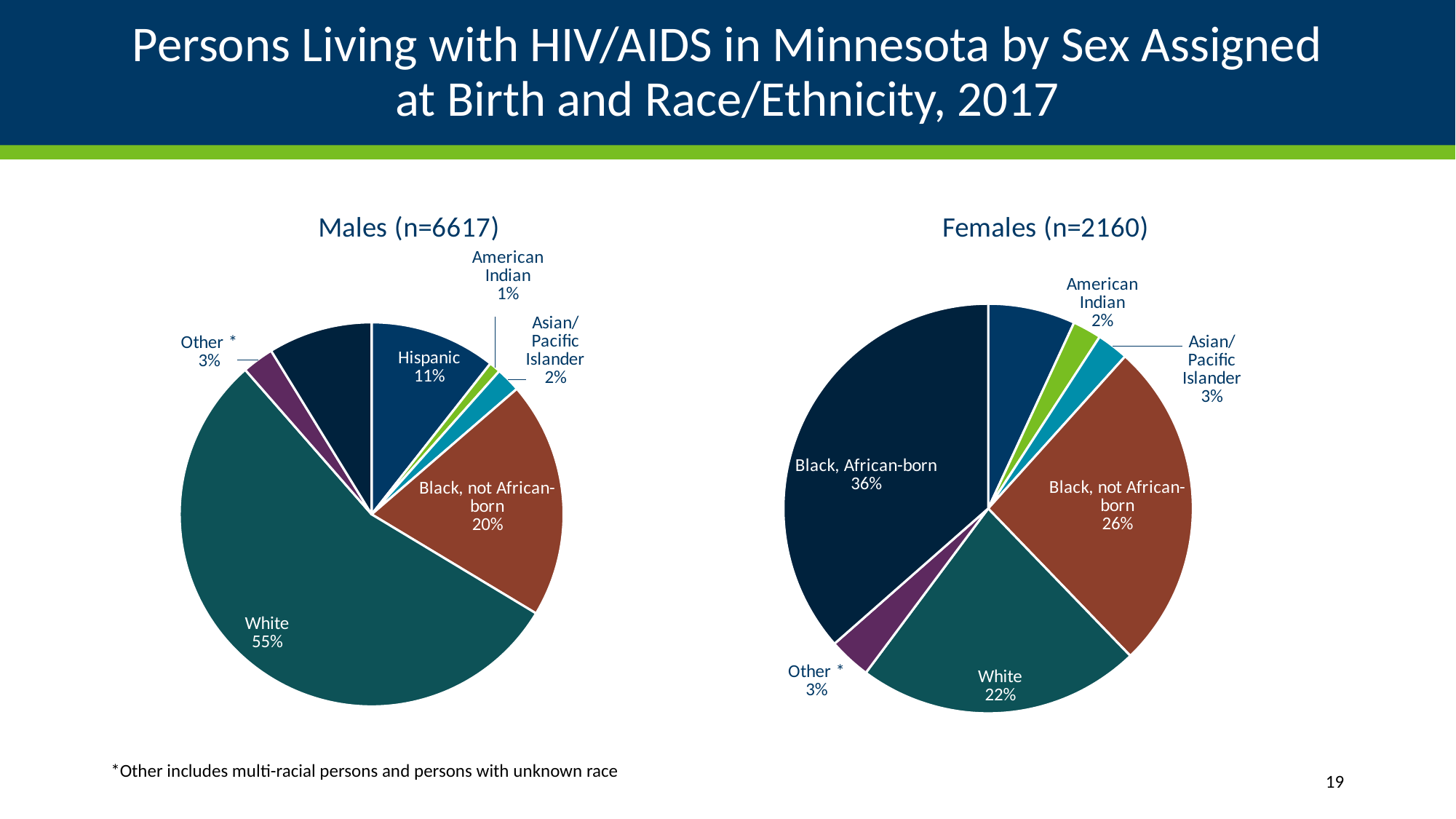
In the Males (n=6617) pie chart, how many percentage points larger is the White share than the Black, not African-born share? 35 percentage points In the Males (n=6617) pie chart, what share of persons are White? 55% In the Females (n=2160) pie chart, which is larger: the White share or the Black, not African-born share? Black, not African-born In the Females (n=2160) pie chart, which race/ethnicity group has the largest slice? Black, African-born In the Females (n=2160) pie chart, what percentage is labeled for Asian/Pacific Islander? 3% What type of chart is used for the Males (n=6617) data? Pie chart How many slices does the Males (n=6617) pie chart have? 7 In the Males (n=6617) pie chart, what percentage is labeled for Hispanic? 11% In the Males (n=6617) pie chart, which race/ethnicity group has the largest slice? White What is the sample size (n) shown in the title of the Females pie chart? 2160 In the Females (n=2160) pie chart, what share of persons are Black, African-born? 36% In the Males (n=6617) pie chart, which labeled group has the smallest share? American Indian